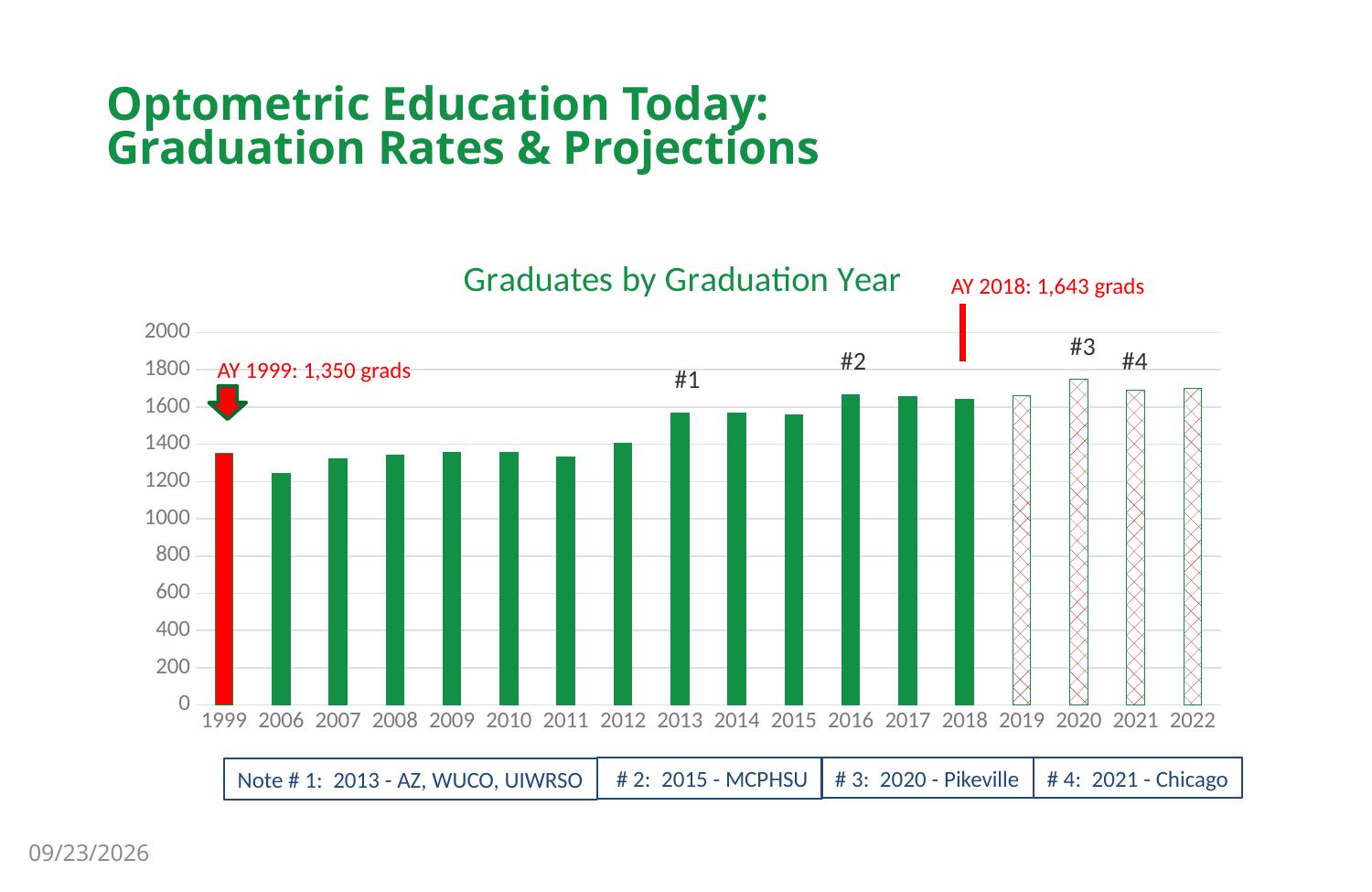
What is the difference between the number of graduates in AY 2018 and AY 1999? 293 How many graduation years are plotted on the x axis? 18 Do the number of graduates generally rise or fall from 2006 to 2013? rise Is the value for 2006 greater or less than 1400? less Which graduation year has the highest bar? 2020 What kind of chart is shown on the slide? bar chart Which year has more graduates, 2016 or 2006? 2016 Which graduation year has the lowest number of graduates? 2006 How many graduates are shown for AY 1999? 1,350 grads Is the value for 2016 greater or less than 1600? greater What is the title of the chart? Graduates by Graduation Year How many graduates are shown for AY 2018? 1,643 grads